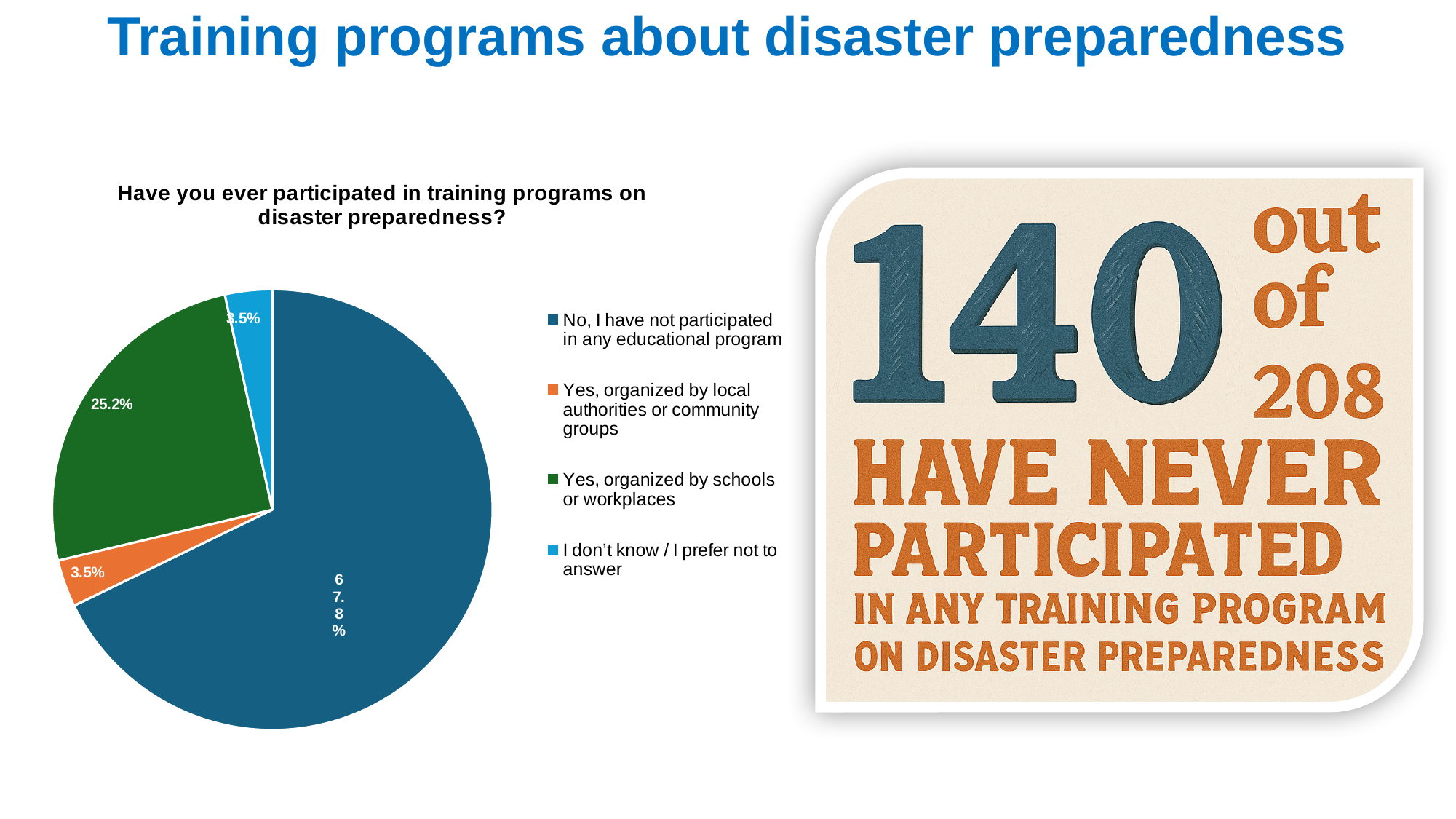
What kind of chart is shown on the slide? pie chart What percentage of respondents answered "No, I have not participated in any educational program"? 67.8% Which response has the largest share of the pie? No, I have not participated in any educational program How many entries does the legend list? 4 What percentage of respondents answered "Yes, organized by local authorities or community groups"? 3.5% What percentage of respondents answered "I don't know / I prefer not to answer"? 3.5% Which is larger: the share for "Yes, organized by schools or workplaces" or the share for "Yes, organized by local authorities or community groups"? Yes, organized by schools or workplaces What colour is the slice for "Yes, organized by schools or workplaces"? green How many slices does the pie chart have? 4 What is the title of the chart? Have you ever participated in training programs on disaster preparedness? What is the difference in percentage points between the "No, I have not participated in any educational program" slice and the "Yes, organized by schools or workplaces" slice? 42.6 What percentage of respondents answered "Yes, organized by schools or workplaces"? 25.2%